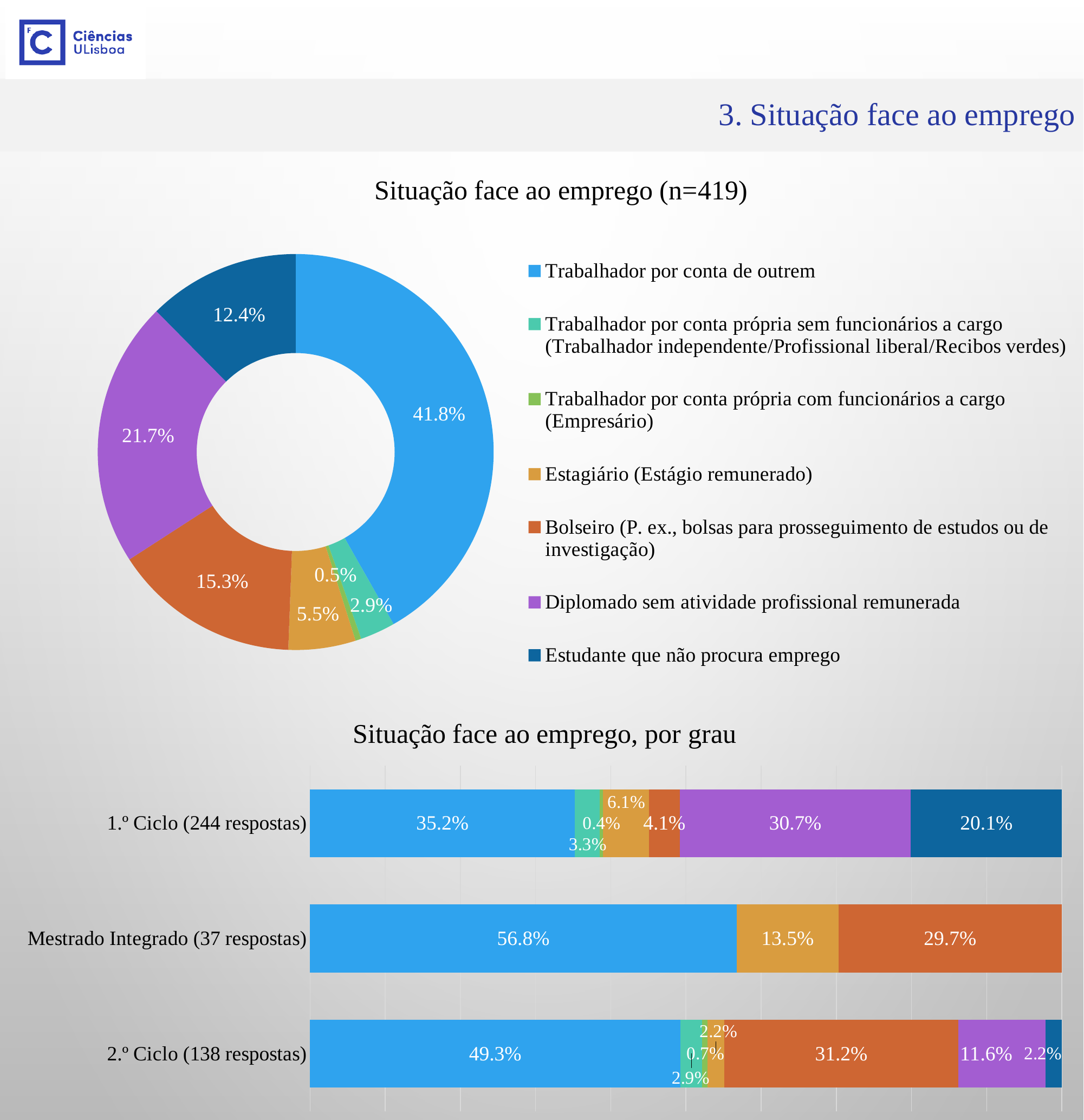
What kind of chart is 'Situação face ao emprego (n=419)'? Doughnut (pie) chart In the chart 'Situação face ao emprego, por grau', what is the value for 'Estudante que não procura emprego' in '1.º Ciclo (244 respostas)'? 20.1% In the chart 'Situação face ao emprego (n=419)', which category has the smallest share? Trabalhador por conta própria com funcionários a cargo (Empresário) How many categories does the legend of the chart 'Situação face ao emprego (n=419)' list? 7 What kind of chart is 'Situação face ao emprego, por grau'? Stacked bar chart In the chart 'Situação face ao emprego (n=419)', which category has the largest share? Trabalhador por conta de outrem In the chart 'Situação face ao emprego, por grau', what is the value for 'Trabalhador por conta de outrem' in 'Mestrado Integrado (37 respostas)'? 56.8% In the chart 'Situação face ao emprego (n=419)', what share is 'Diplomado sem atividade profissional remunerada'? 21.7% In the chart 'Situação face ao emprego, por grau', which degree has the larger 'Bolseiro' share: '2.º Ciclo (138 respostas)' or '1.º Ciclo (244 respostas)'? 2.º Ciclo (138 respostas) In the chart 'Situação face ao emprego (n=419)', what is the difference between the shares of 'Bolseiro' and 'Estudante que não procura emprego'? 2.9% In the chart 'Situação face ao emprego (n=419)', what share is 'Trabalhador por conta de outrem'? 41.8% How many degree categories are shown in the chart 'Situação face ao emprego, por grau'? 3